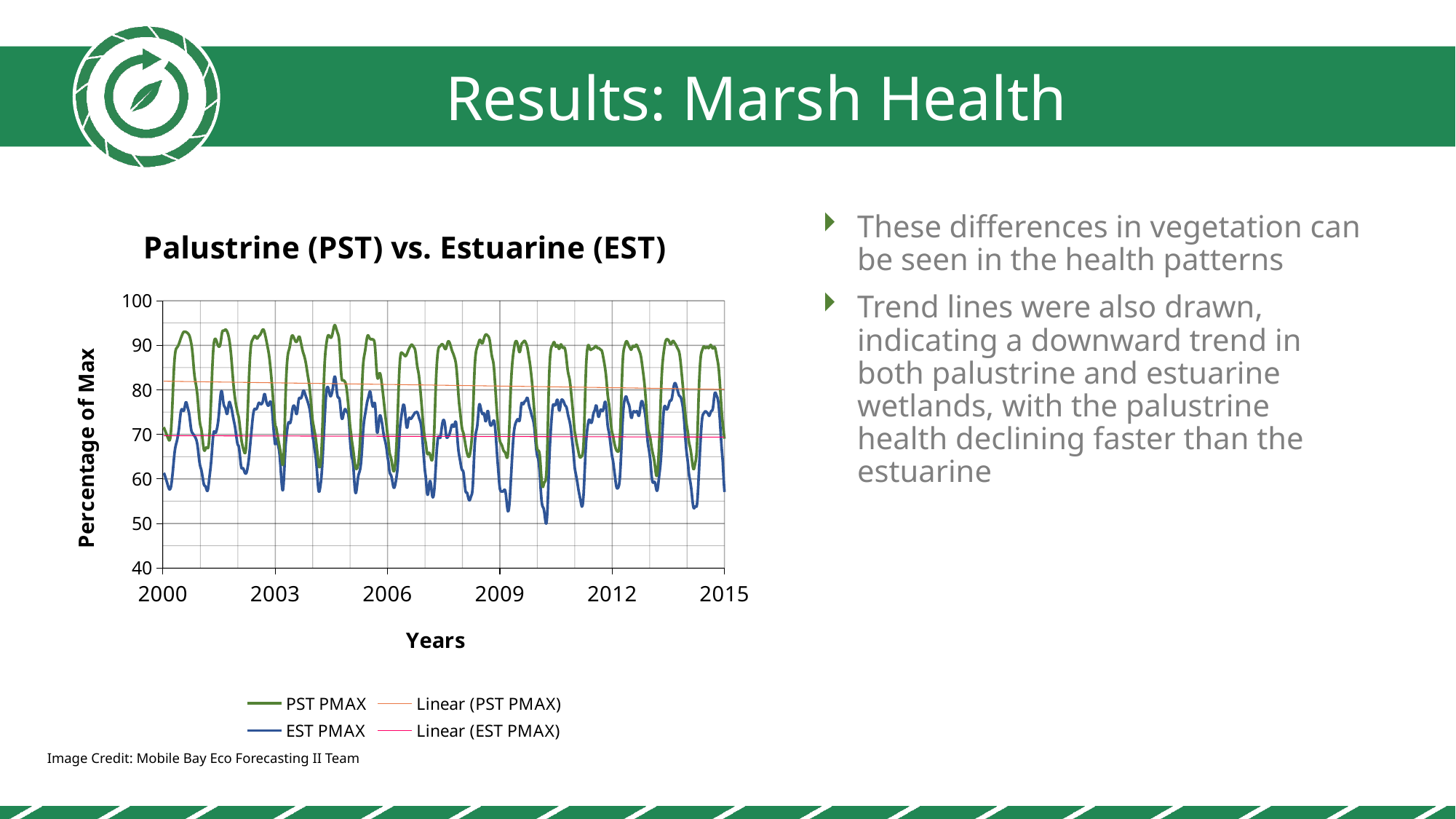
What is the last year shown on the x axis? 2015 Which trend line sits higher on the chart, Linear (PST PMAX) or Linear (EST PMAX)? Linear (PST PMAX) Is the lowest value reached by EST PMAX greater or less than 60? less Does the Linear (PST PMAX) trend line rise or fall from 2000 to 2015? fall Is the Linear (EST PMAX) trend line above or below 80 on the y axis? below What is the title of the chart? Palustrine (PST) vs. Estuarine (EST) Is the highest value reached by PST PMAX greater or less than 90? greater How many entries does the chart's legend list? 4 How many year labels are shown on the x axis? 6 Which series generally has higher values, PST PMAX or EST PMAX? PST PMAX What kind of chart is shown on the slide? Line chart What is the label of the chart's y axis? Percentage of Max